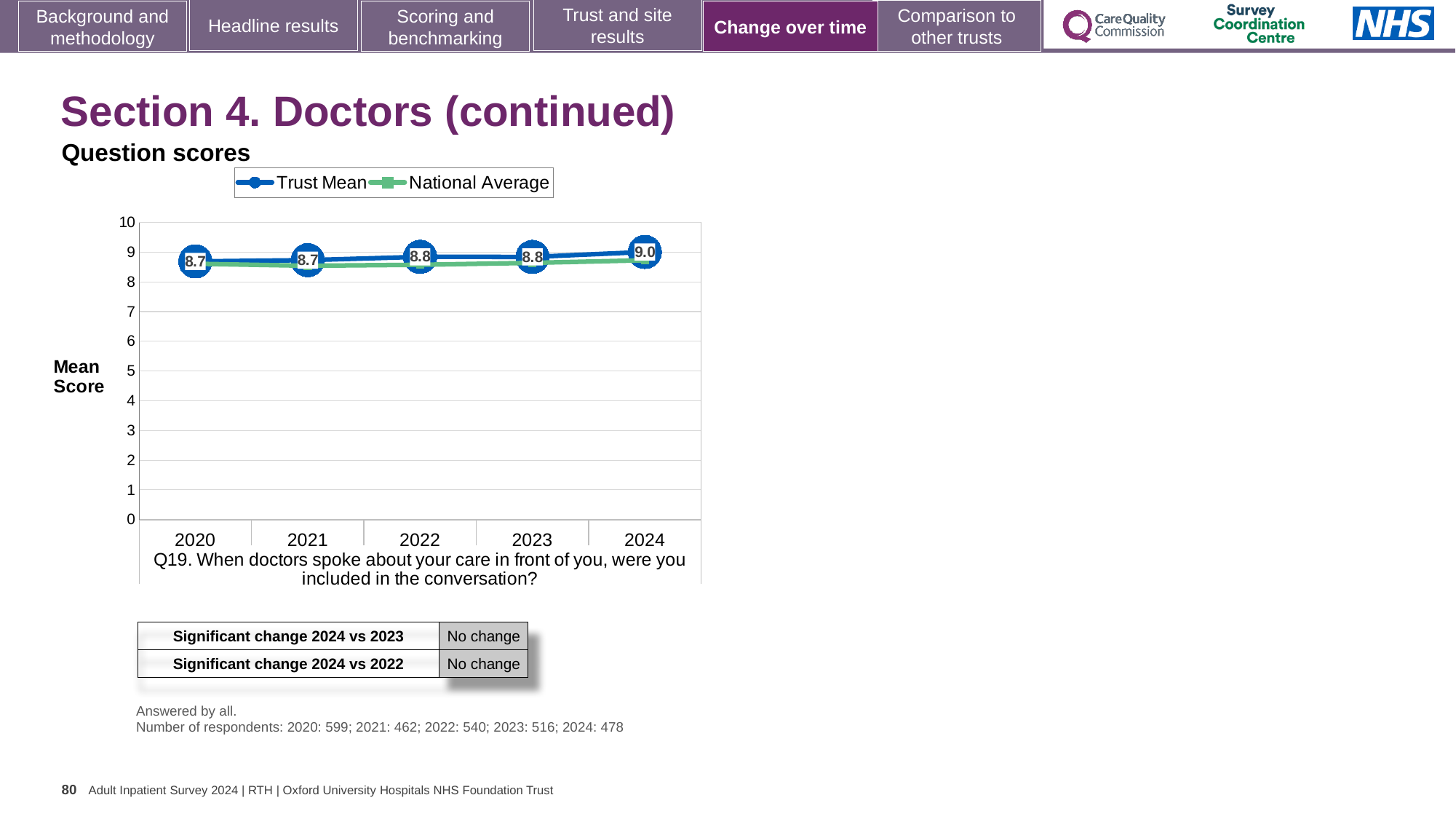
Which is larger, the Trust Mean score for 2024 or for 2022? 2024 Is the National Average value for 2024 greater or less than 8? greater In which year is the Trust Mean score highest? 2024 Does the Trust Mean score rise or fall from 2020 to 2024? Rise What kind of chart is shown? Line chart What is the Trust Mean score for 2022? 8.8 How many years are plotted on the x axis? 5 What is the Trust Mean score for 2020? 8.7 What are the two series named in the legend? Trust Mean and National Average What is the difference between the Trust Mean score in 2024 and in 2020? 0.3 How many series does the legend list? 2 What is the Trust Mean score for 2024? 9.0